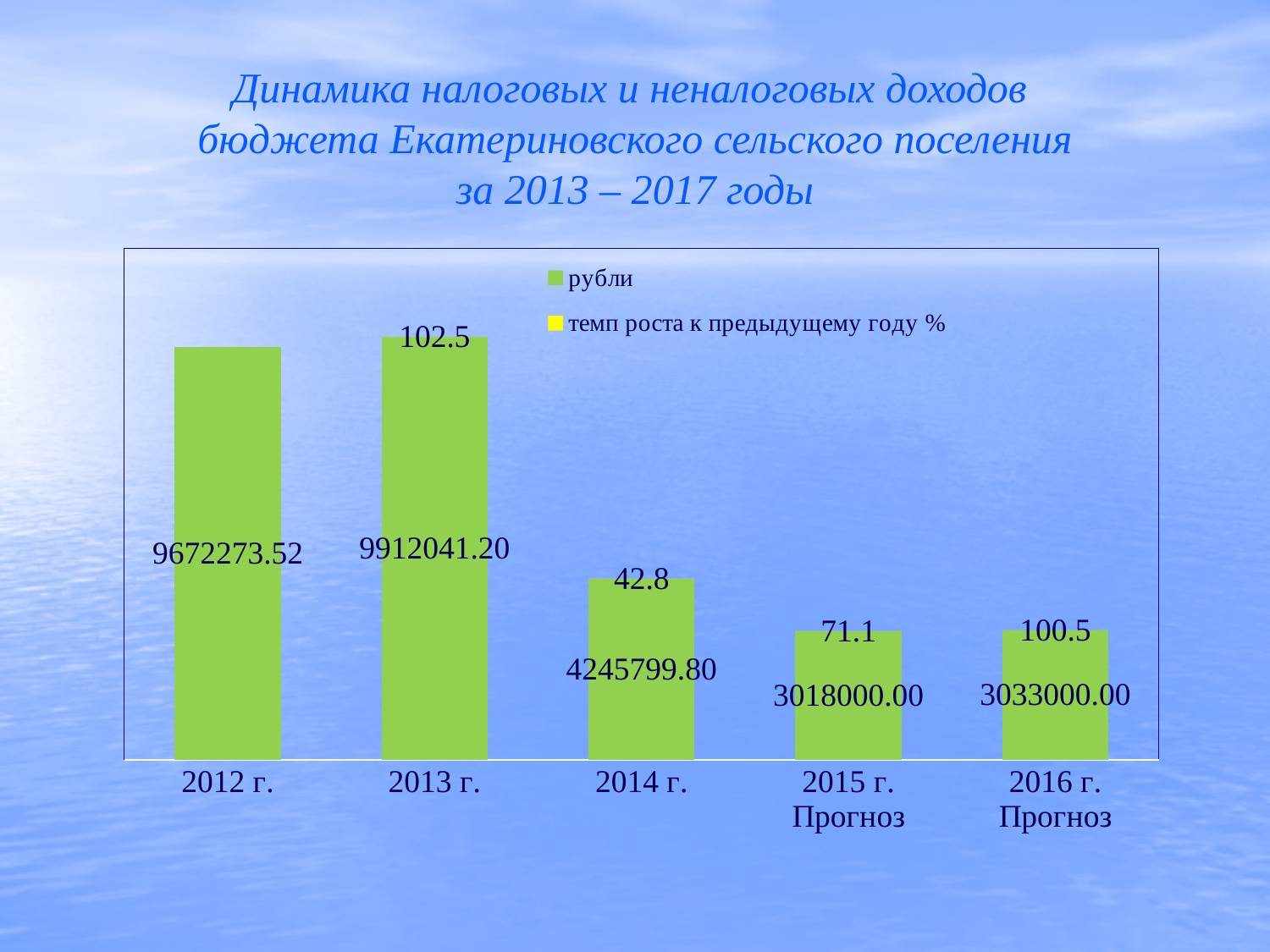
What is the value in рубли for 2012 г.? 9672273.52 Which year has the highest value in рубли? 2013 г. What is the value in рубли for 2016 г. Прогноз? 3033000.00 What is the темп роста к предыдущему году % for 2014 г.? 42.8 What is the value in рубли for 2014 г.? 4245799.80 What is the темп роста к предыдущему году % for 2015 г. Прогноз? 71.1 What type of chart is shown on the slide? bar chart What is the difference in рубли between 2013 г. and 2012 г.? 239767.68 Do the рубли values generally rise or fall from 2013 г. to 2015 г. Прогноз? fall How many year categories are shown on the x axis? 5 Which is larger, the рубли value for 2012 г. or for 2014 г.? 2012 г. How many series does the legend list? 2